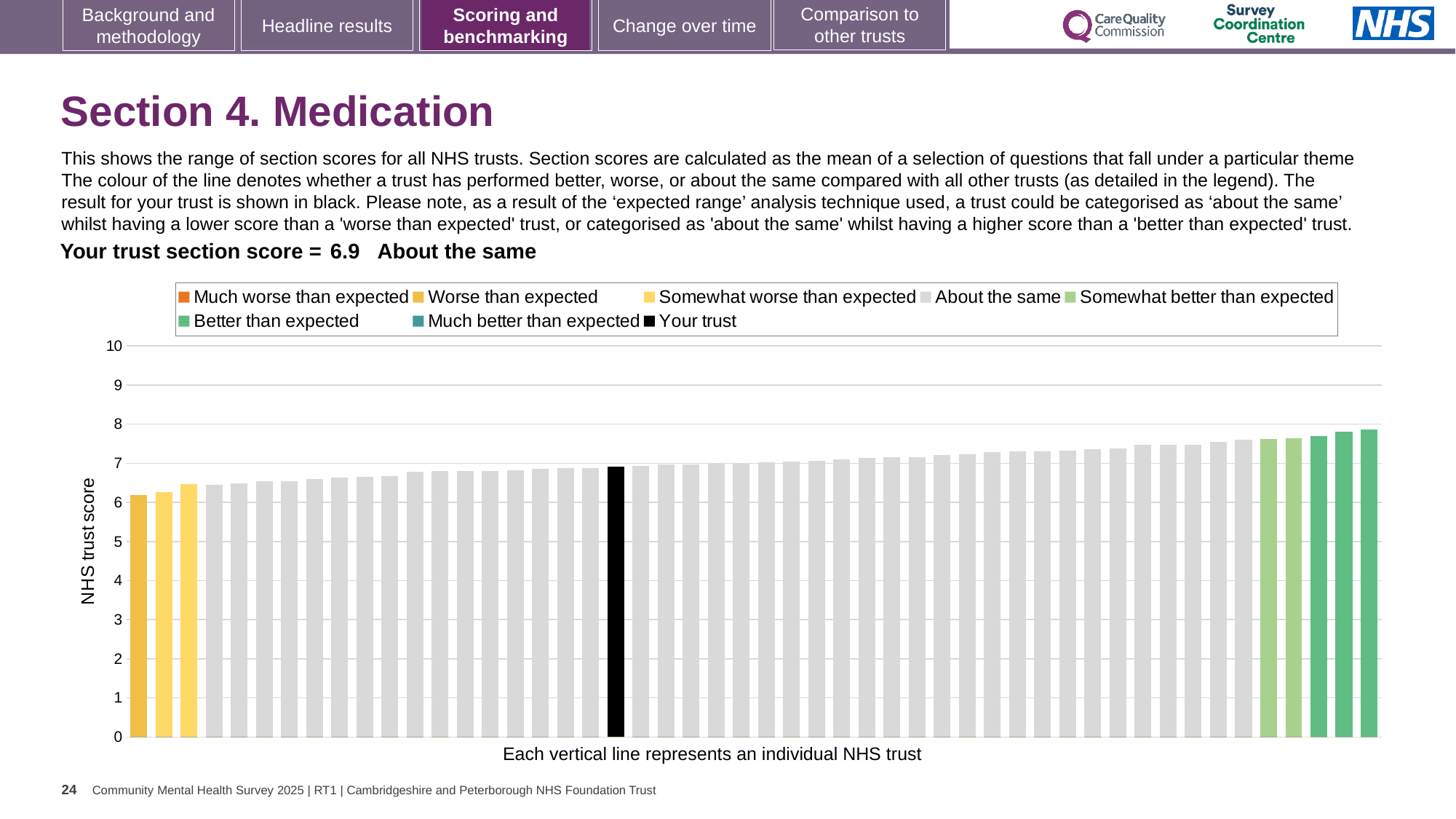
How many entries does the chart legend list? 8 How many bars on the chart are coloured yellow? 3 Is the value of the shortest bar greater or less than 7? less Is the value of the tallest bar greater or less than 7? greater What is the section score for your trust shown on the slide? 6.9 Is the value of the tallest bar greater or less than 8? less What type of chart is shown on the slide? bar chart What is the title of the vertical axis? NHS trust score Do the bar values rise or fall from left to right along the x axis? rise Which performance category is your trust placed in for Section 4. Medication? About the same